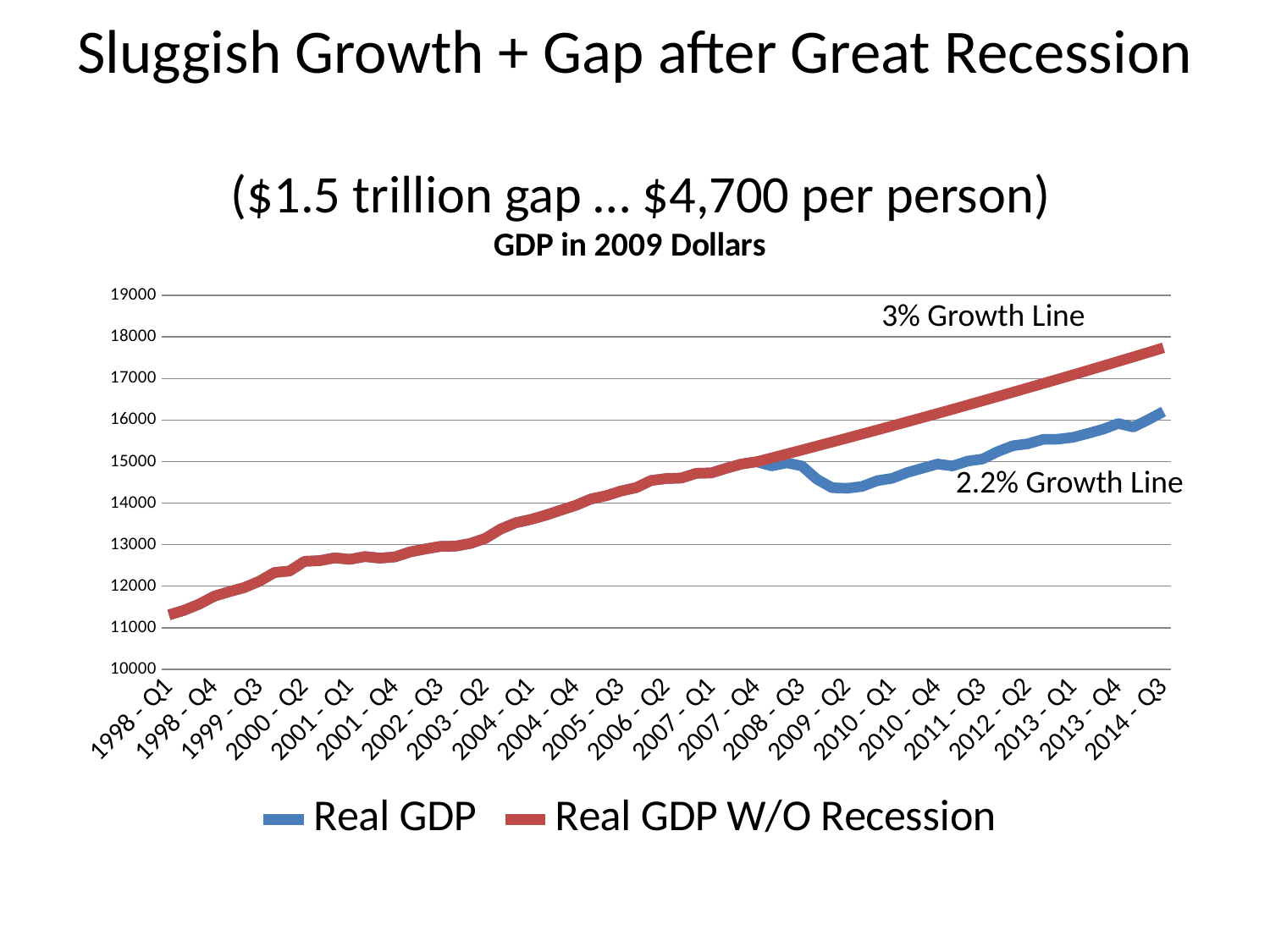
At 2014 - Q3, which series is higher: Real GDP or Real GDP W/O Recession? Real GDP W/O Recession What is the title of the chart? GDP in 2009 Dollars Which colour is used for the Real GDP series? blue Is the value of Real GDP W/O Recession at 2014 - Q3 greater or less than 17000? greater Does the Real GDP series rise or fall between 2008 - Q3 and 2009 - Q2? fall Which series has the lowest value on the chart at 2010 - Q1? Real GDP Is the value of Real GDP at 2009 - Q2 greater or less than 15000? less Is the value of Real GDP at 1998 - Q1 greater or less than 12000? less What kind of chart is shown on the slide? line chart Does the Real GDP W/O Recession series rise or fall from 1998 - Q1 to 2014 - Q3? rise How many series does the chart legend list? 2